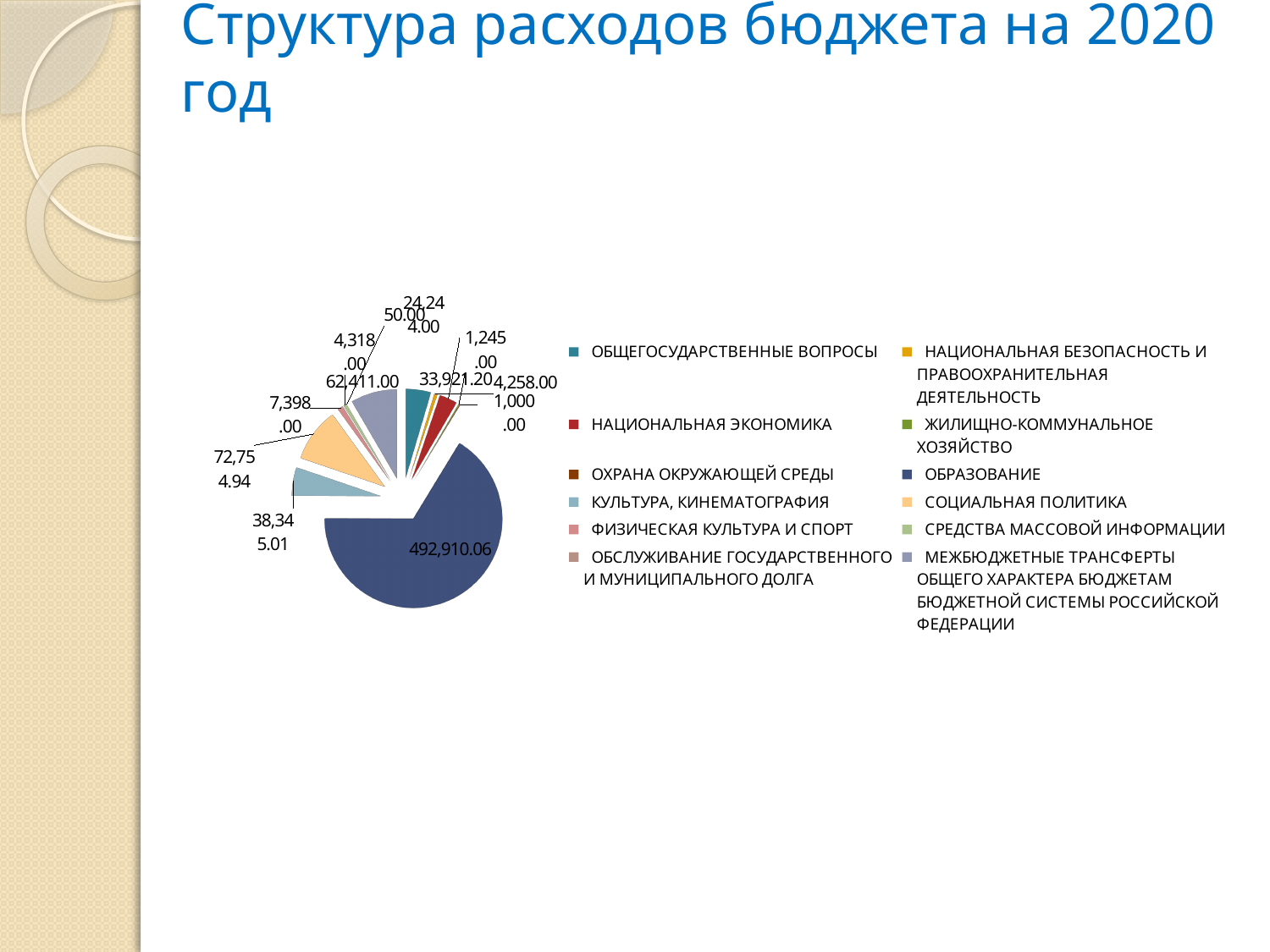
What is the title of the slide's chart? Структура расходов бюджета на 2020 год What colour is the slice for ОБРАЗОВАНИЕ in the legend? dark blue How many categories does the chart legend list? 12 Which is larger, the slice for СОЦИАЛЬНАЯ ПОЛИТИКА or the slice for НАЦИОНАЛЬНАЯ ЭКОНОМИКА? СОЦИАЛЬНАЯ ПОЛИТИКА Which is larger, the slice for ОБРАЗОВАНИЕ or the slice for СОЦИАЛЬНАЯ ПОЛИТИКА? ОБРАЗОВАНИЕ What is the value shown for СОЦИАЛЬНАЯ ПОЛИТИКА? 72,754.94 Which category has the largest slice of the pie? ОБРАЗОВАНИЕ What is the value shown for ОБРАЗОВАНИЕ? 492,910.06 Which is larger, the slice for ОБРАЗОВАНИЕ or the slice for КУЛЬТУРА, КИНЕМАТОГРАФИЯ? ОБРАЗОВАНИЕ What kind of chart is shown on the slide? pie chart What is the value shown for МЕЖБЮДЖЕТНЫЕ ТРАНСФЕРТЫ ОБЩЕГО ХАРАКТЕРА БЮДЖЕТАМ БЮДЖЕТНОЙ СИСТЕМЫ РОССИЙСКОЙ ФЕДЕРАЦИИ? 62,411.00